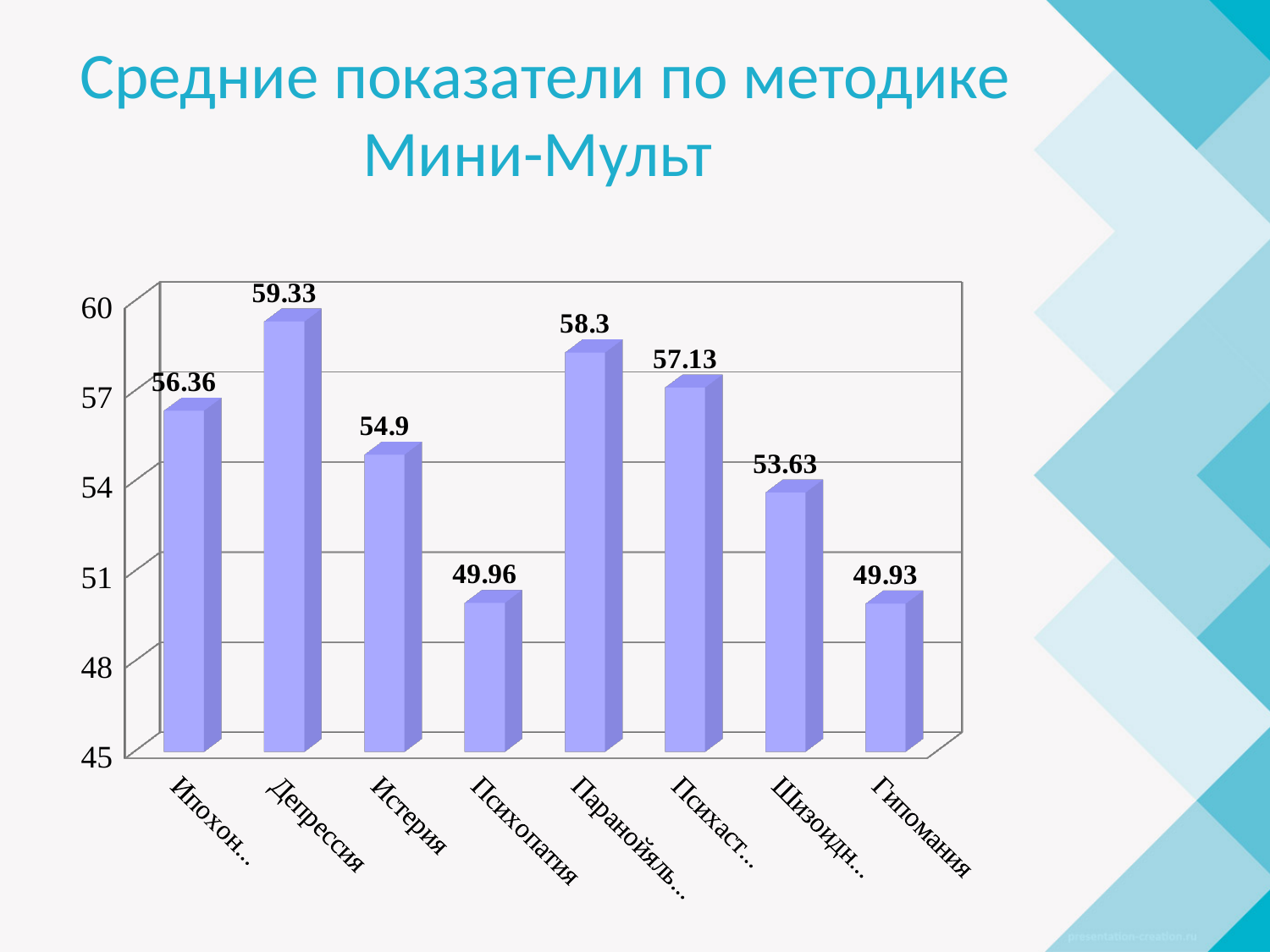
Is the value for Психопатия greater or less than 51? less What is the value for Гипомания? 49.93 What kind of chart is shown on the slide? bar chart Is the value for Истерия greater or less than 54? greater Which category has the highest value? Депрессия What is the value for Депрессия? 59.33 What is the value for Психопатия? 49.96 Which is larger, the value for Истерия or the value for Гипомания? Истерия What is the difference between the values for Депрессия and Истерия? 4.43 How many categories are shown in the chart? 8 What is the difference between the values for Депрессия and Гипомания? 9.4 What is the value for Истерия? 54.9